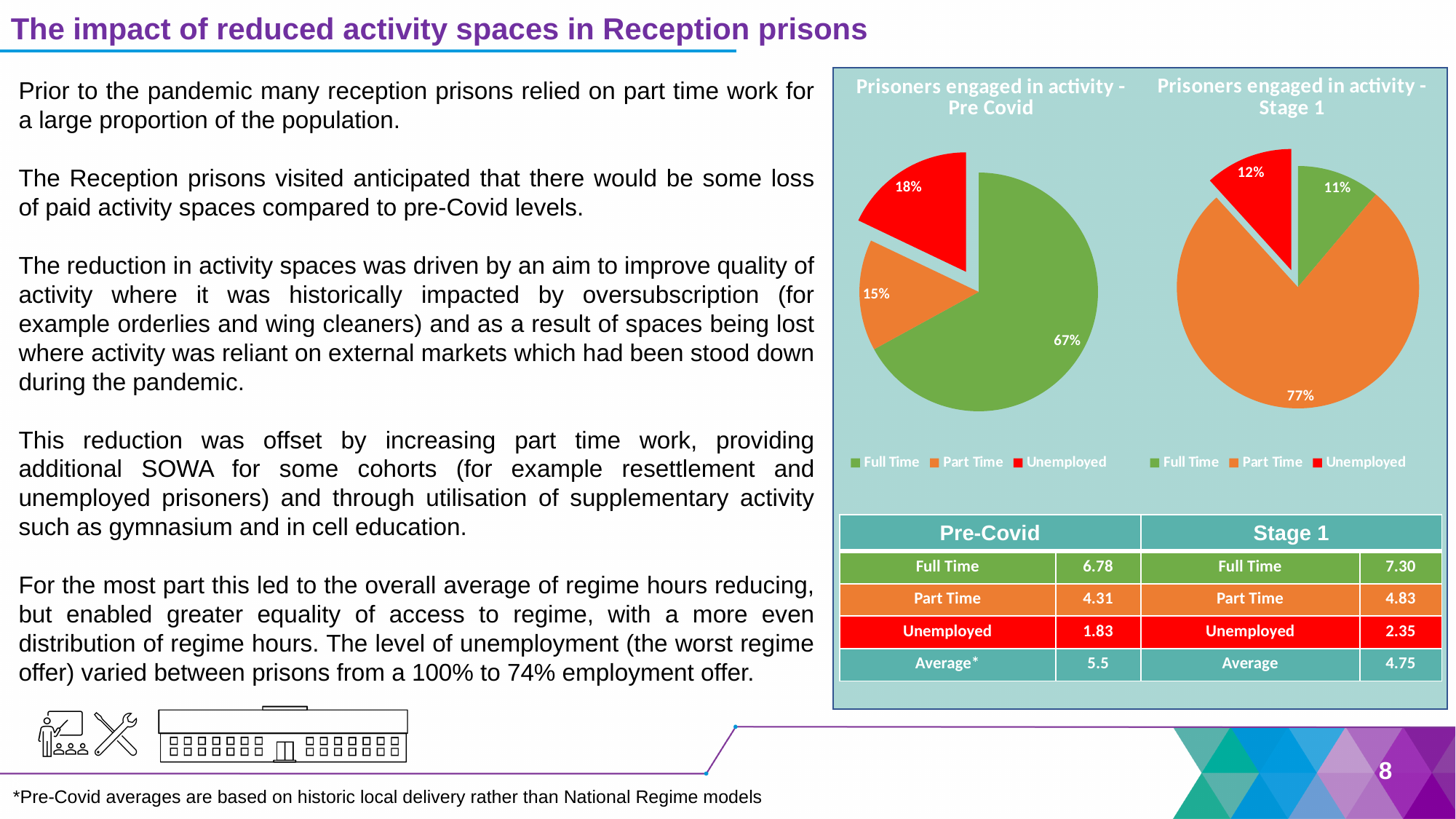
In the 'Prisoners engaged in activity - Pre Covid' chart, which category has the smallest slice? Part Time Is the Unemployed share larger in the 'Pre Covid' chart or the 'Stage 1' chart? Pre Covid What is the difference between the Part Time share in the 'Stage 1' chart and the Part Time share in the 'Pre Covid' chart? 62 percentage points In the 'Prisoners engaged in activity - Stage 1' chart, which category has the smallest slice? Full Time In the 'Prisoners engaged in activity - Pre Covid' chart, what share of prisoners are Full Time? 67% In the 'Prisoners engaged in activity - Pre Covid' chart, what share of prisoners are Unemployed? 18% In the 'Prisoners engaged in activity - Stage 1' chart, what share of prisoners are Part Time? 77% What type of chart is 'Prisoners engaged in activity - Stage 1'? Pie chart In the 'Prisoners engaged in activity - Stage 1' chart, what colour is the Unemployed slice? Red In the 'Prisoners engaged in activity - Stage 1' chart, what share of prisoners are Full Time? 11% In the 'Prisoners engaged in activity - Pre Covid' chart, which category has the largest slice? Full Time How many categories does the legend of the 'Prisoners engaged in activity - Pre Covid' chart list? 3